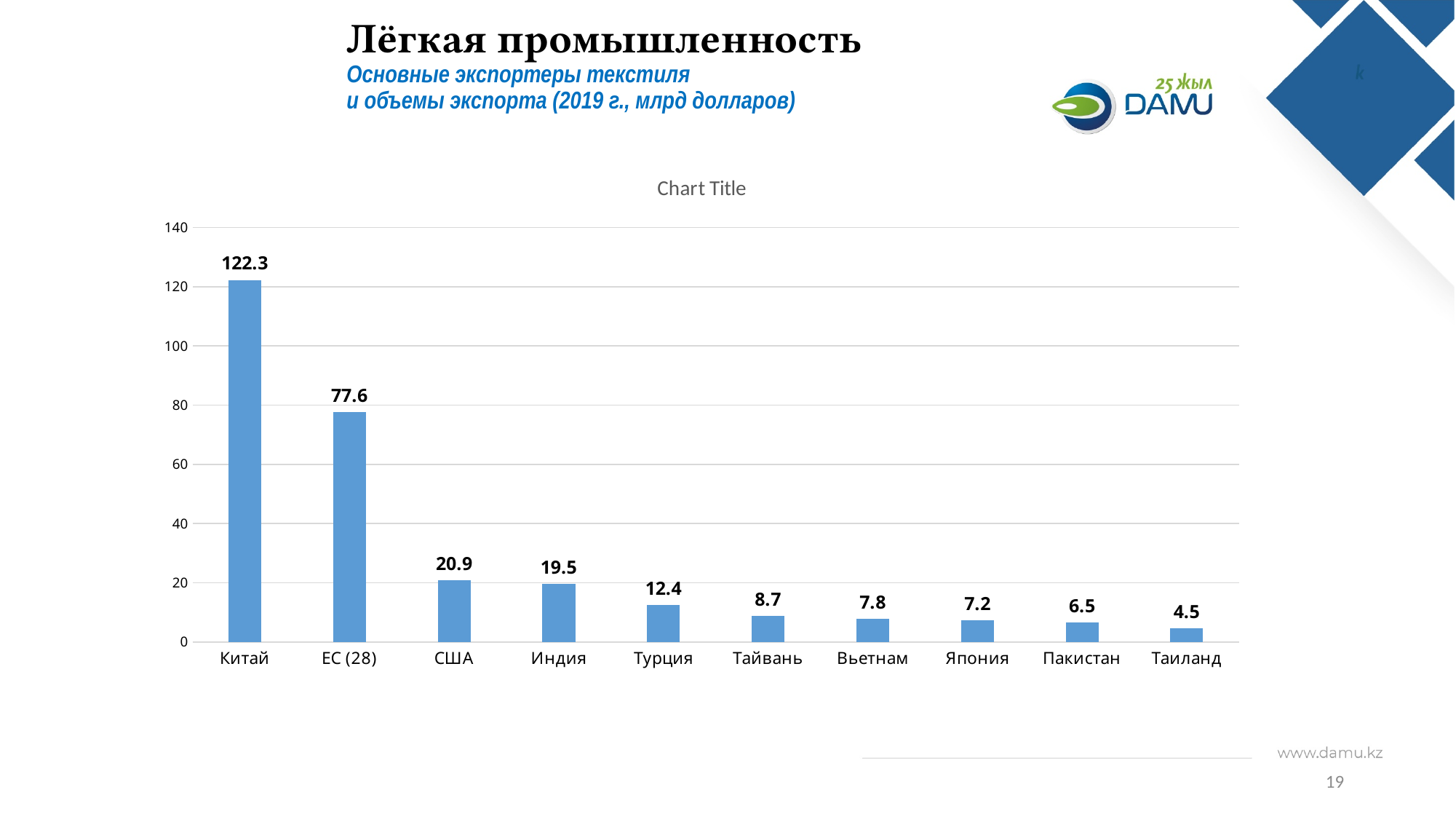
How many categories are shown on the x axis? 10 Which category has the lowest value? Таиланд What is the value for Турция? 12.4 What is the value for Китай? 122.3 Which category has the highest value? Китай What kind of chart is shown on the slide? bar chart What is the value for ЕС (28)? 77.6 Which is larger, the value for Тайвань or the value for Вьетнам? Тайвань What is the difference between the values for Китай and ЕС (28)? 44.7 What is the difference between the values for США and Индия? 1.4 Do the values rise or fall from left to right along the x axis? fall What is the value for Таиланд? 4.5